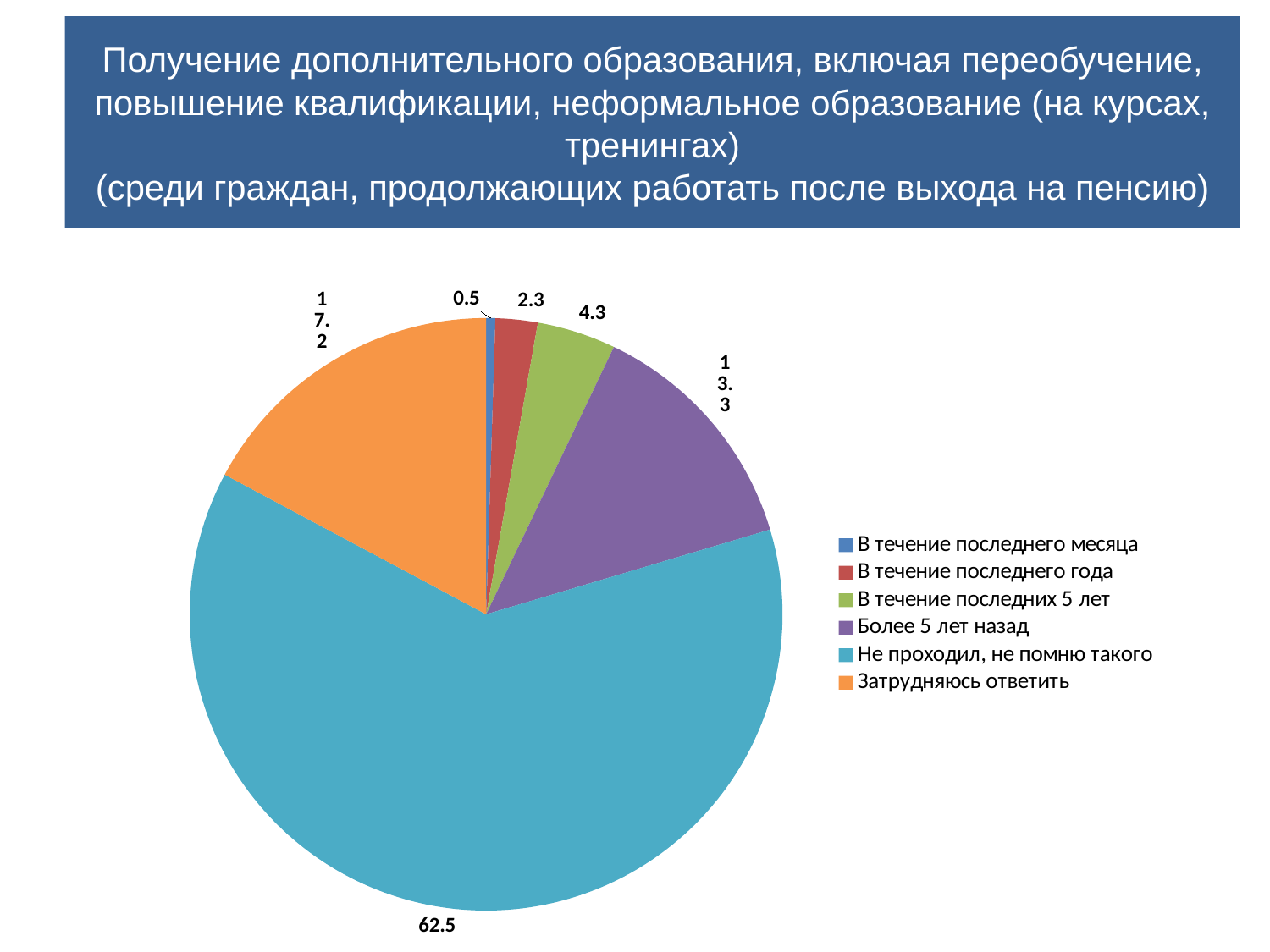
What is the value for "В течение последнего года"? 2.3 What is the value for "В течение последних 5 лет"? 4.3 What kind of chart is shown on the slide? pie chart What is the value for "Затрудняюсь ответить"? 17.2 What is the difference between the values for "Затрудняюсь ответить" and "Более 5 лет назад"? 3.9 How many categories does the legend list? 6 Which is larger: the value for "Более 5 лет назад" or the value for "В течение последних 5 лет"? Более 5 лет назад What is the value for "Не проходил, не помню такого"? 62.5 What is the value for "В течение последнего месяца"? 0.5 Which category has the largest slice of the pie? Не проходил, не помню такого Which category has the smallest slice of the pie? В течение последнего месяца What is the value for "Более 5 лет назад"? 13.3